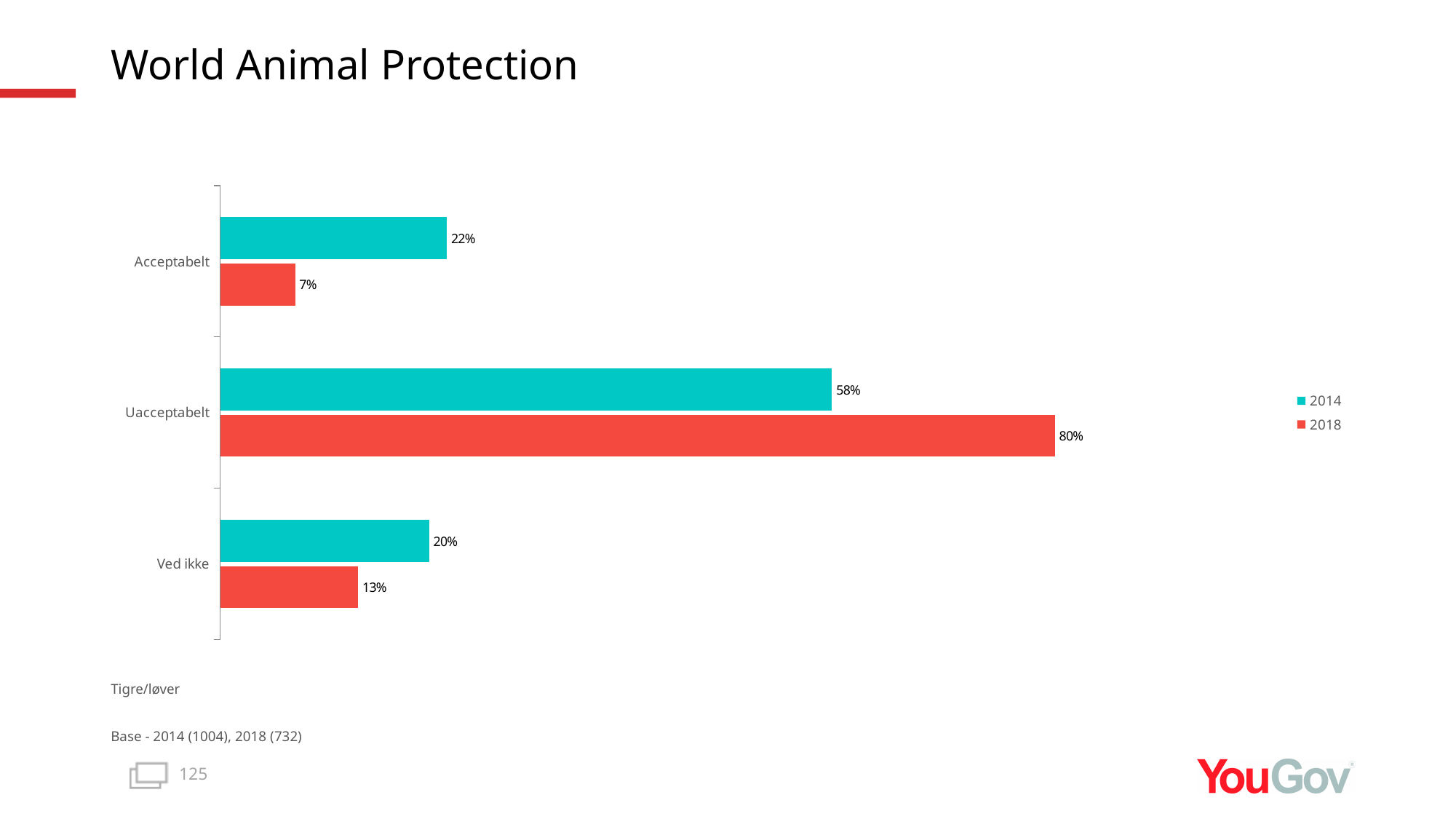
What is the 2014 value for Acceptabelt? 22% What is the 2018 value for Uacceptabelt? 80% How many series does the legend list? 2 What is the difference between the 2014 and 2018 values for Acceptabelt? 15 percentage points What kind of chart is shown on the slide? Bar chart What is the difference between the 2018 and 2014 values for Uacceptabelt? 22 percentage points What is the 2014 value for Ved ikke? 20% Which is larger for Ved ikke: the 2014 value or the 2018 value? 2014 Which category has the highest 2018 value? Uacceptabelt Which category has the lowest 2018 value? Acceptabelt How many categories are shown on the chart? 3 What is the 2018 value for Ved ikke? 13%